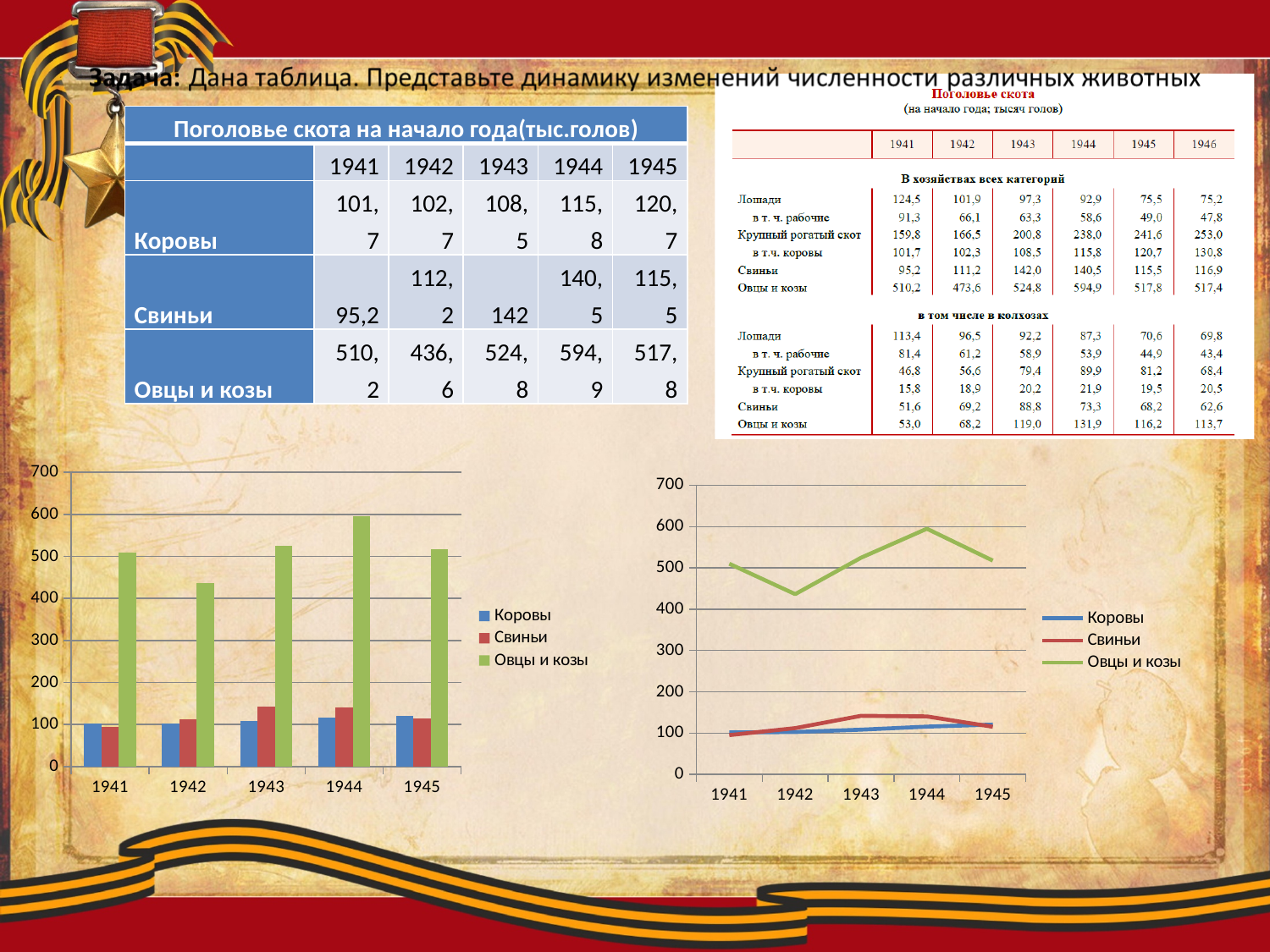
In the line chart on the bottom right, is the value for Овцы и козы in 1944 greater or less than 500? greater What kind of chart is the chart on the bottom right of the slide? line chart In the line chart on the bottom right, which series is plotted with the green line? Овцы и козы In the bar chart on the bottom left, in which year is the bar for Овцы и козы the tallest? 1944 In the line chart on the bottom right, how many years are shown on the x axis? 5 In the line chart on the bottom right, does the line for Коровы rise or fall from 1941 to 1945? rise In the bar chart on the bottom left, how many series does the legend list? 3 In the bar chart on the bottom left, is the value for Свиньи in 1944 greater or less than 100? greater In the bar chart on the bottom left, is the value for Овцы и козы in 1942 greater or less than 500? less In the bar chart on the bottom left, which is larger in 1943: Коровы or Свиньи? Свиньи What kind of chart is the chart on the bottom left of the slide? bar chart In the bar chart on the bottom left, in which year is the bar for Овцы и козы the shortest? 1942